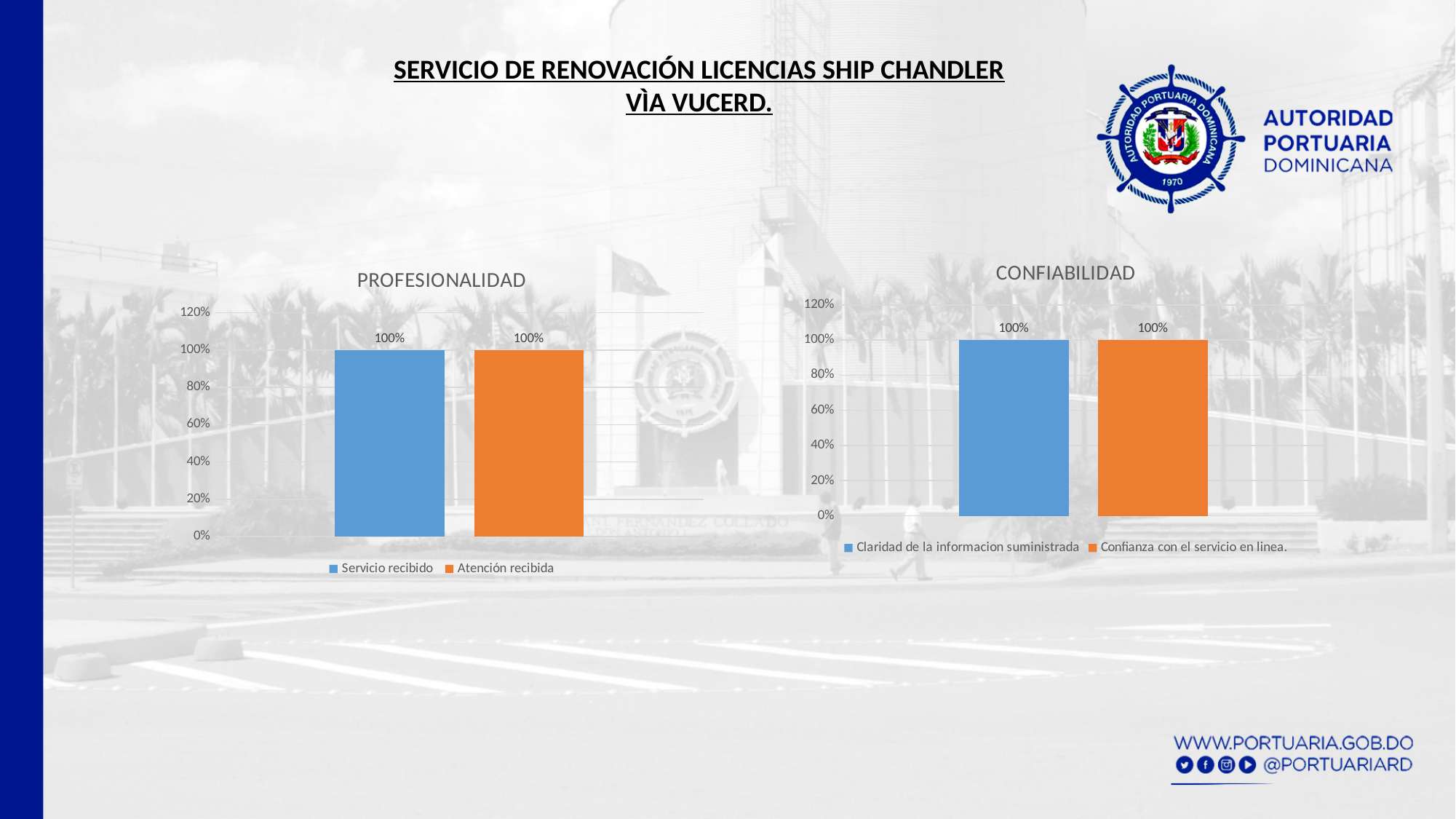
In the PROFESIONALIDAD chart, what is the value for Atención recibida? 100% What kind of chart is the CONFIABILIDAD chart? Bar chart How many series does the legend of the PROFESIONALIDAD chart list? 2 In the PROFESIONALIDAD chart, what is the difference between Servicio recibido and Atención recibida? 0% How many series does the legend of the CONFIABILIDAD chart list? 2 In the PROFESIONALIDAD chart, what colour is the bar for Atención recibida? Orange In the CONFIABILIDAD chart, what is the difference between Claridad de la informacion suministrada and Confianza con el servicio en linea? 0% In the CONFIABILIDAD chart, what is the value for Claridad de la informacion suministrada? 100% In the CONFIABILIDAD chart, what is the value for Confianza con el servicio en linea? 100% In the CONFIABILIDAD chart, is the value for Confianza con el servicio en linea greater or less than 120%? less In the PROFESIONALIDAD chart, what is the value for Servicio recibido? 100% In the PROFESIONALIDAD chart, is the value for Servicio recibido greater or less than 80%? greater